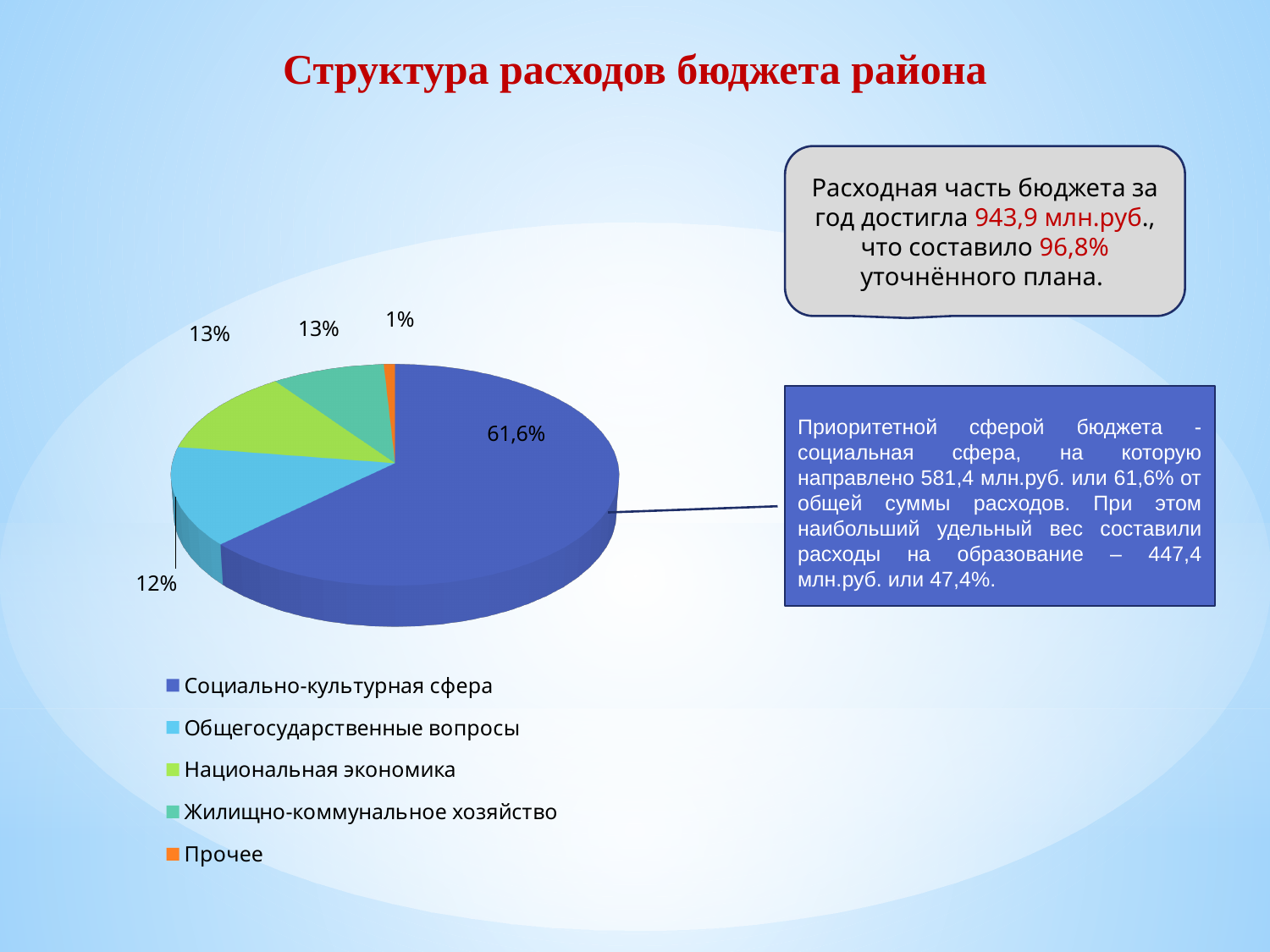
Which category has the largest slice of the pie? Социально-культурная сфера Which category has the smallest slice of the pie? Прочее Which legend entry is shown in orange? Прочее Which is larger: the share of Жилищно-коммунальное хозяйство or the share of Прочее? Жилищно-коммунальное хозяйство What kind of chart is shown on the slide? pie chart How many categories does the pie chart have? 5 What is the difference between the shares of Социально-культурная сфера and Общегосударственные вопросы? 49,6% What is the value shown for Общегосударственные вопросы? 12% What is the value shown for Национальная экономика? 13% What share of the pie does Социально-культурная сфера take? 61,6% What is the value shown for Прочее? 1% What is the title of the slide containing the chart? Структура расходов бюджета района